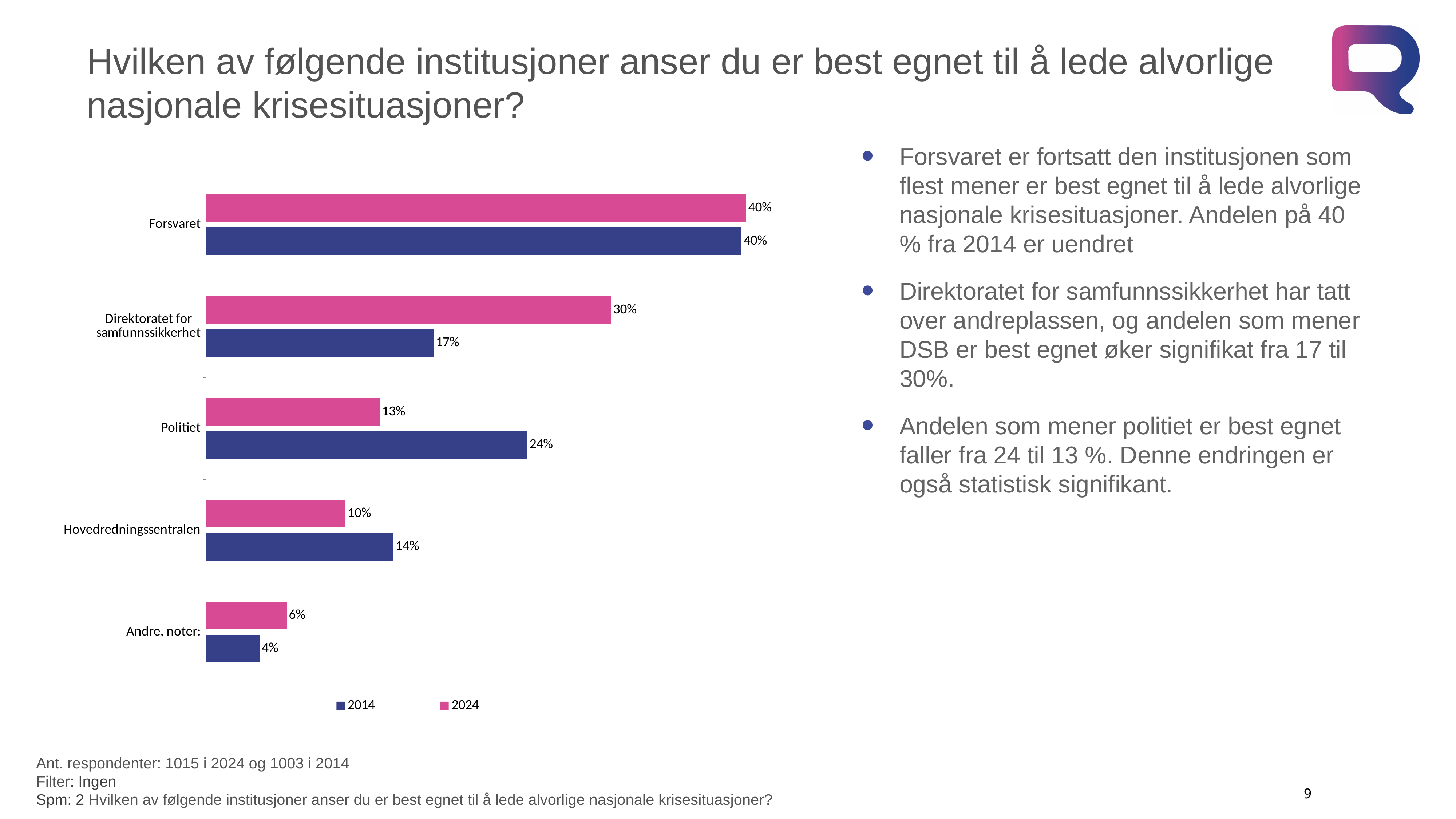
What is the difference between the 2024 and 2014 values for Direktoratet for samfunnssikkerhet? 13% How many series does the legend list? 2 What is the 2024 value for Direktoratet for samfunnssikkerhet? 30% Which category has the lowest 2014 value? Andre, noter: What is the 2014 value for Andre, noter:? 4% Which category has the highest 2024 value? Forsvaret What is the 2024 value for Hovedredningssentralen? 10% How many categories are shown in the chart? 5 What is the 2014 value for Politiet? 24% Which is larger for Hovedredningssentralen, the 2014 value or the 2024 value? 2014 What kind of chart is shown on the slide? Bar chart What is the difference between the 2014 and 2024 values for Politiet? 11%